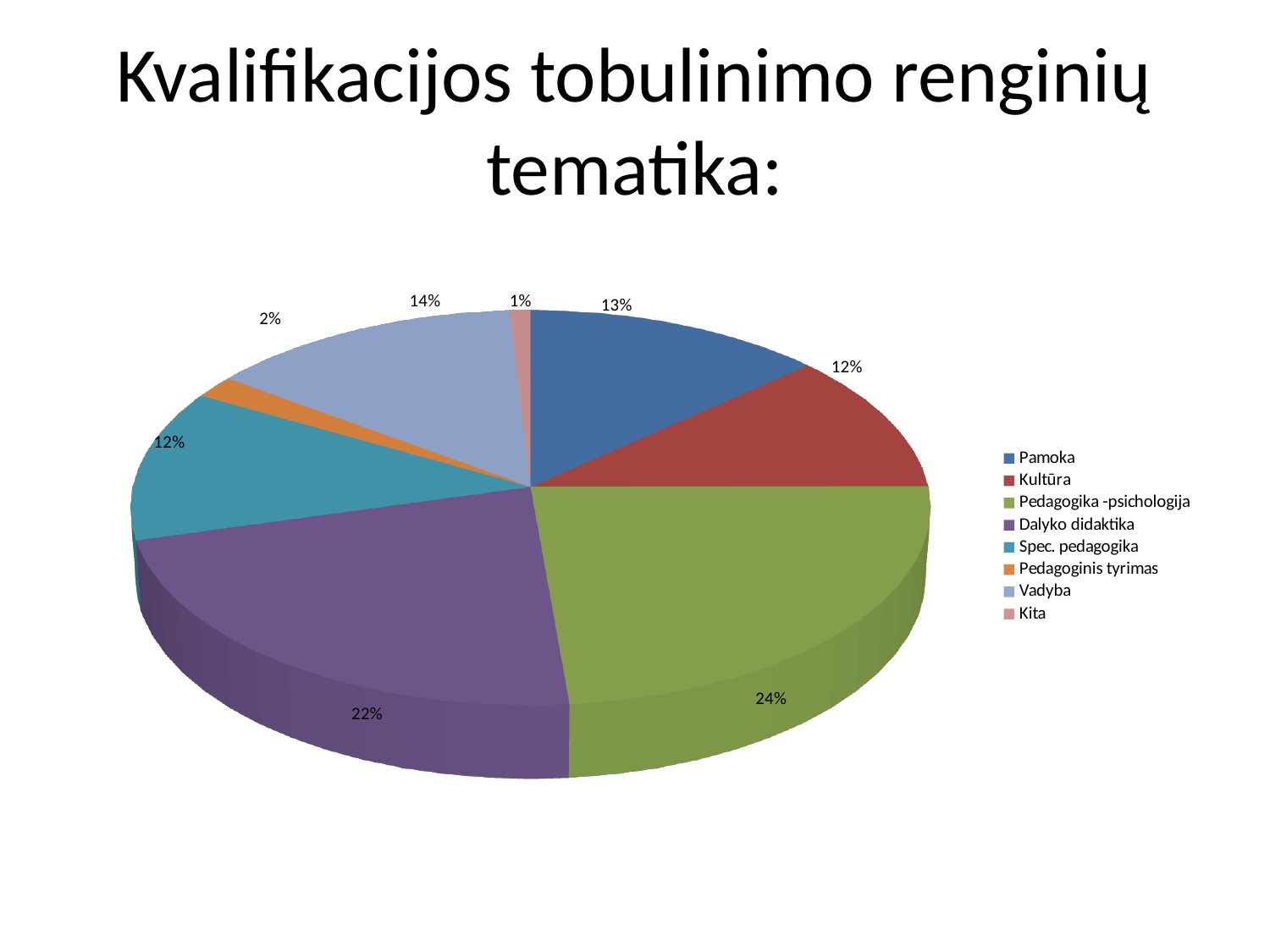
Which category has the largest slice of the pie? Pedagogika -psichologija What is the title of the slide? Kvalifikacijos tobulinimo renginių tematika: Which is larger, the share for Vadyba or the share for Pamoka? Vadyba What is the difference in percentage points between Pedagogika -psichologija and Dalyko didaktika? 2 What share of the pie does Pedagogika -psichologija have? 24% What kind of chart is shown on the slide? pie chart Which category has the smallest slice of the pie? Kita What share of the pie does Pamoka have? 13% What share of the pie does Dalyko didaktika have? 22% How many categories does the legend list? 8